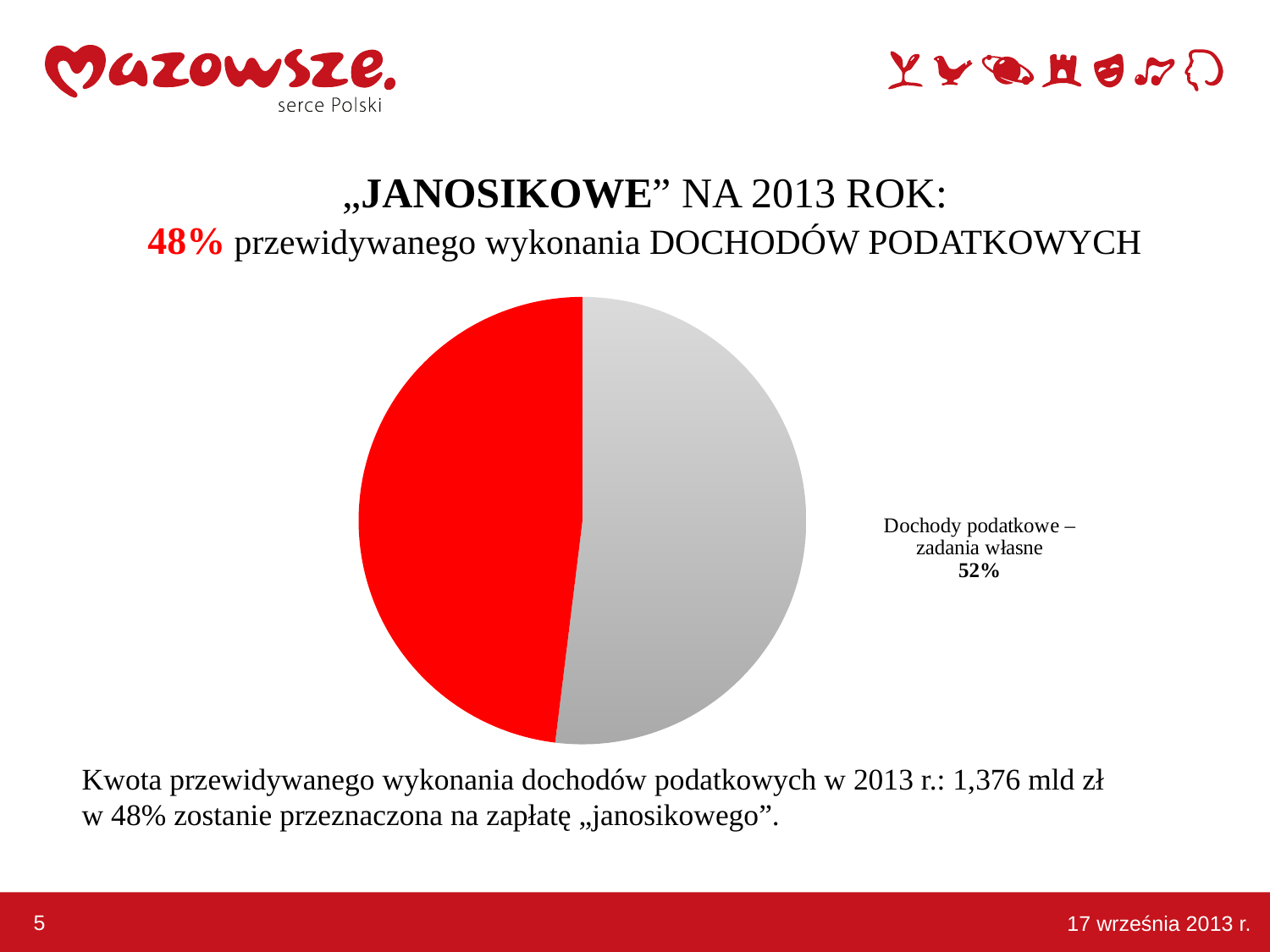
What colour is the slice labelled "Dochody podatkowe – zadania własne"? grey What kind of chart is shown on the slide? pie chart What year does the chart title refer to? 2013 Which category has the largest share of the pie? Dochody podatkowe – zadania własne How many slices does the pie chart have? 2 What is the difference in percentage points between the "Dochody podatkowe – zadania własne" slice and the "janosikowe" slice? 4% What share of the pie does the red slice, representing "janosikowe", account for? 48% Is the share of the grey slice greater or less than 50%? greater Which slice of the pie is larger: the red slice or the grey slice? the grey slice What share of the pie is labelled "Dochody podatkowe – zadania własne"? 52%